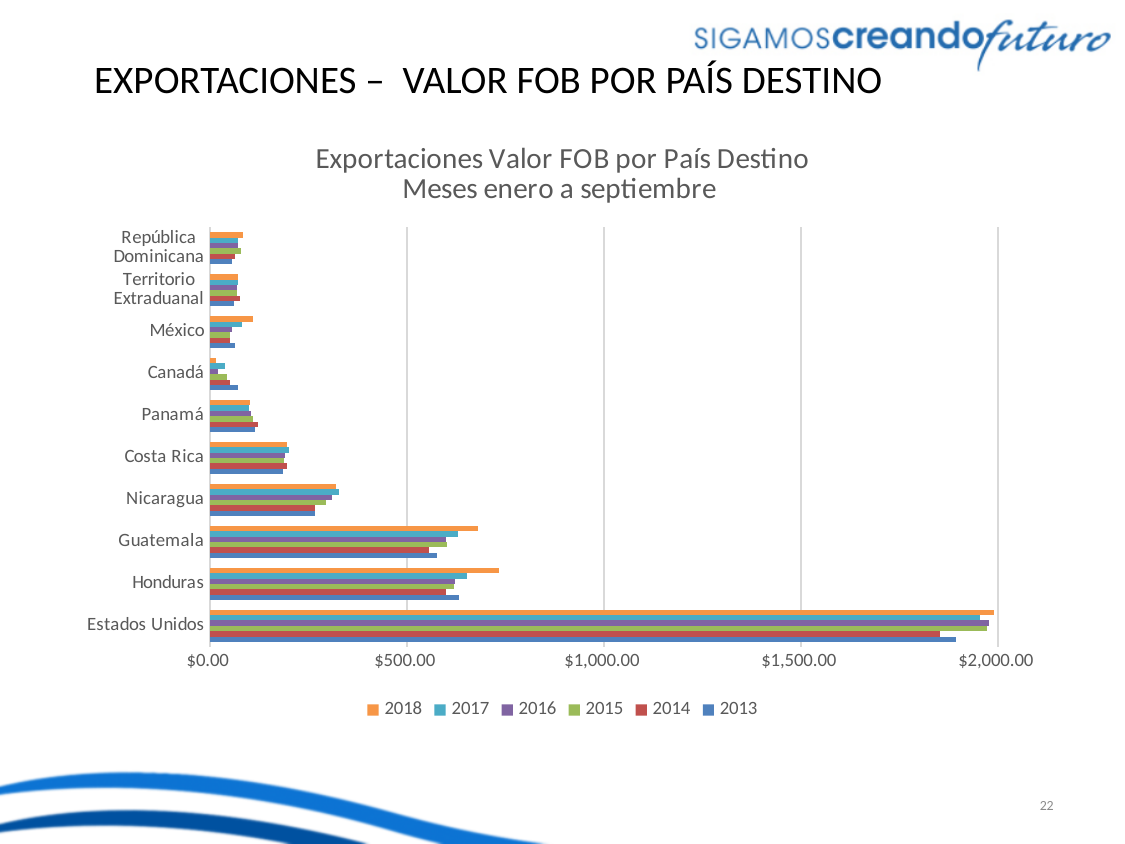
Is the 2018 value for Costa Rica greater or less than $500.00? less Which destination has the lowest export values in the chart? Canadá How many series does the legend list? 6 How many destination countries or categories are listed on the chart? 10 Is the 2018 value for Honduras greater or less than $500.00? greater Which year is listed first in the chart legend? 2018 Is the 2018 value for Estados Unidos greater or less than $1,500.00? greater Which has the larger 2018 value, Honduras or Guatemala? Honduras Which has the larger 2018 value, Nicaragua or Costa Rica? Nicaragua What kind of chart is shown on the slide? bar chart Which destination has the highest export value in the chart? Estados Unidos